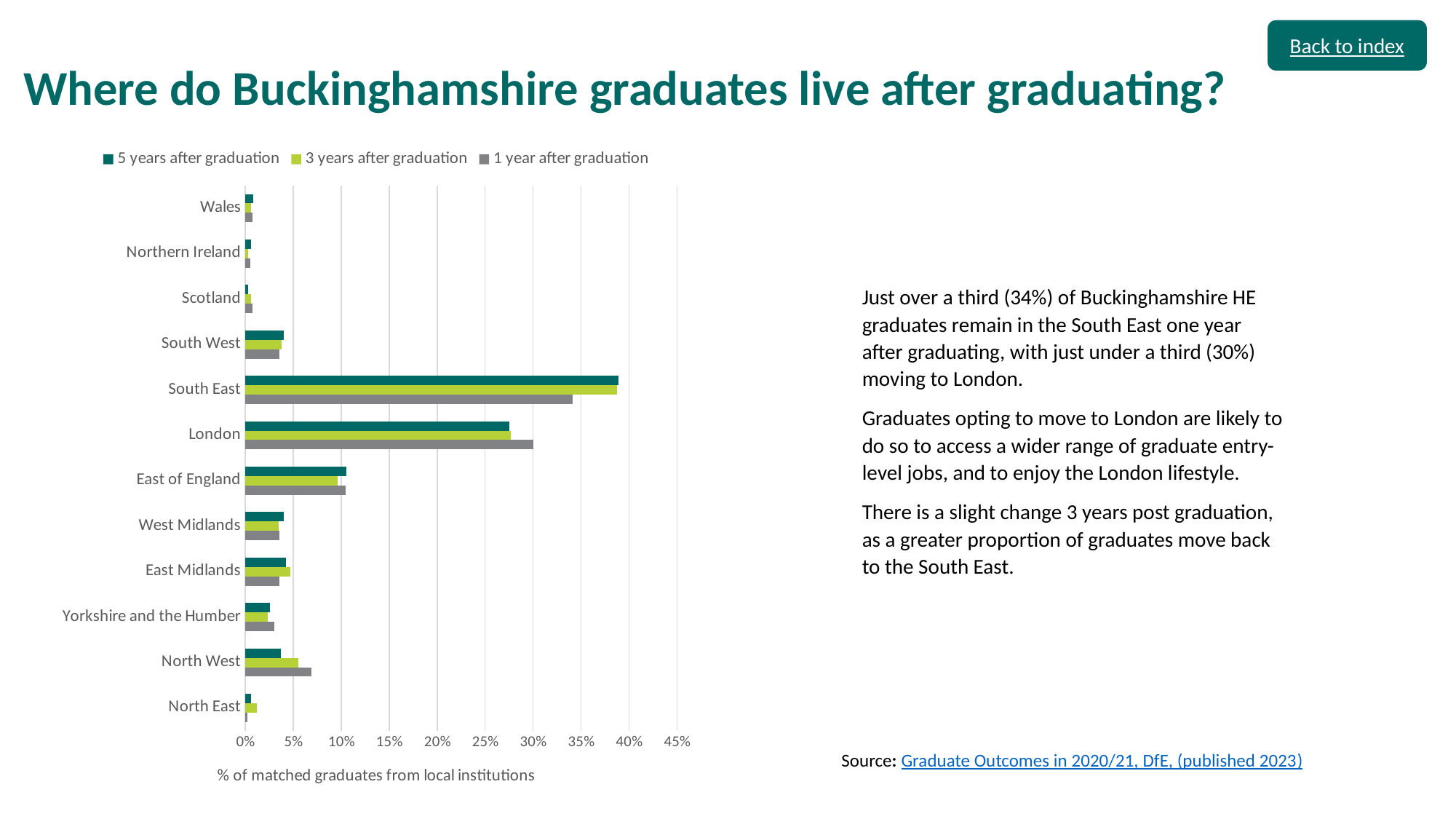
Is the value for South East 5 years after graduation greater or less than 35%? greater Which is larger 5 years after graduation: South East or London? South East How many regions are shown on the chart? 12 Which region has the lowest value for 1 year after graduation? North East Is the value for Wales 5 years after graduation greater or less than 5%? less What is the label on the horizontal axis of the chart? % of matched graduates from local institutions What kind of chart is shown on the slide? Bar chart What percentage of graduates live in London 1 year after graduation? 30% Which region has the highest value for 5 years after graduation? South East How many series does the legend list? 3 What percentage of graduates remain in the South East 1 year after graduation? 34% Is the value for North West 1 year after graduation greater or less than 5%? greater